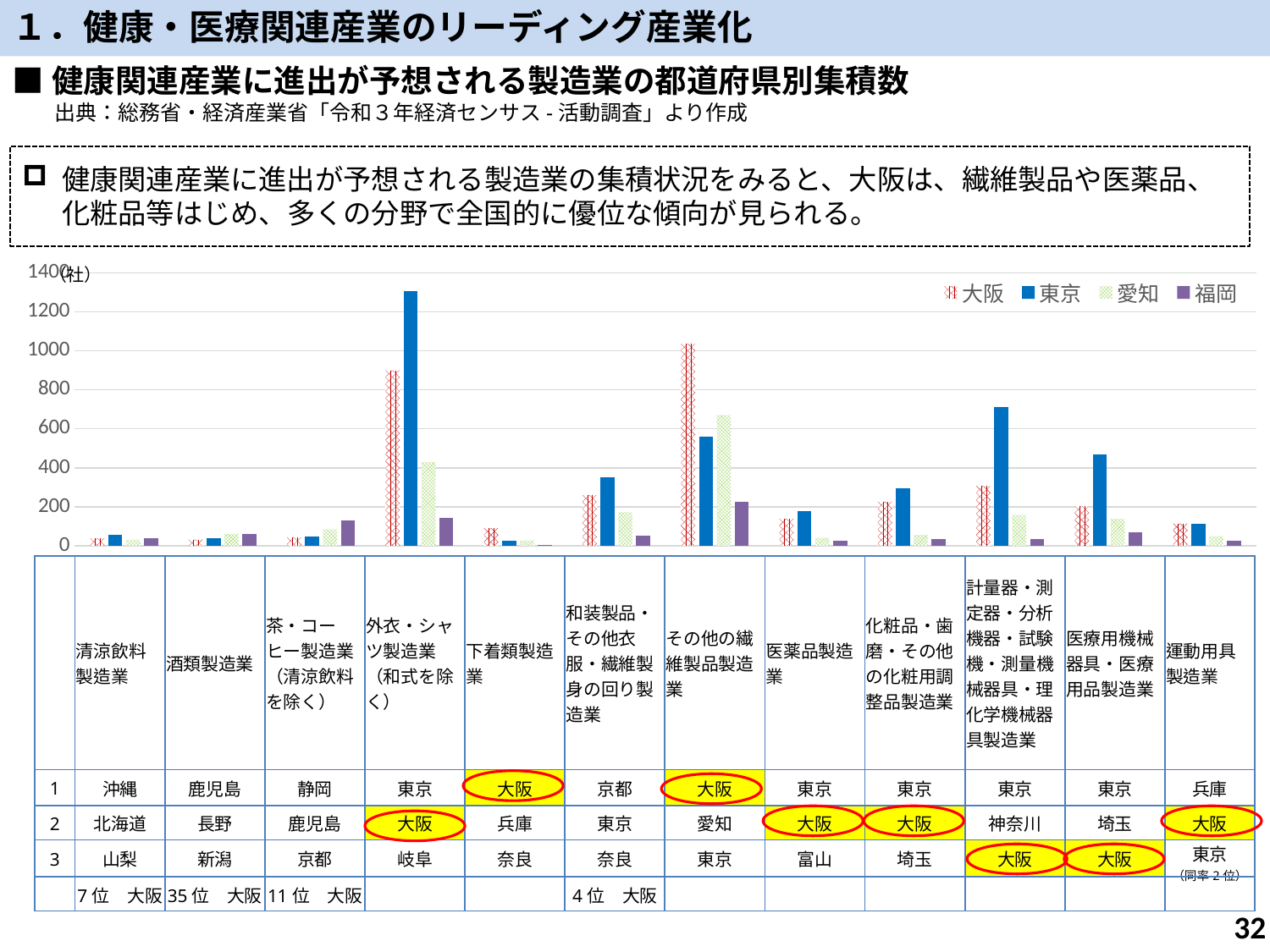
How many industry categories are plotted along the x axis of the chart? 12 What kind of chart is shown on the slide? bar chart Is the 東京 value for 計量器・測定器・分析機器・試験機・測量機械器具・理化学機械器具製造業 greater or less than 600? greater In その他の繊維製品製造業, which is larger, the 大阪 bar or the 東京 bar? 大阪 Which industry category has the tallest 大阪 bar in the chart? その他の繊維製品製造業 Is the 東京 value for 医療用機械器具・医療用品製造業 greater or less than 400? greater In 外衣・シャツ製造業（和式を除く）, which is larger, the 大阪 bar or the 東京 bar? 東京 Is the 大阪 value for その他の繊維製品製造業 greater or less than 800? greater How many series does the chart legend list? 4 What unit is shown at the top of the chart's vertical axis? (社) Which industry category has the tallest 東京 bar in the chart? 外衣・シャツ製造業（和式を除く）